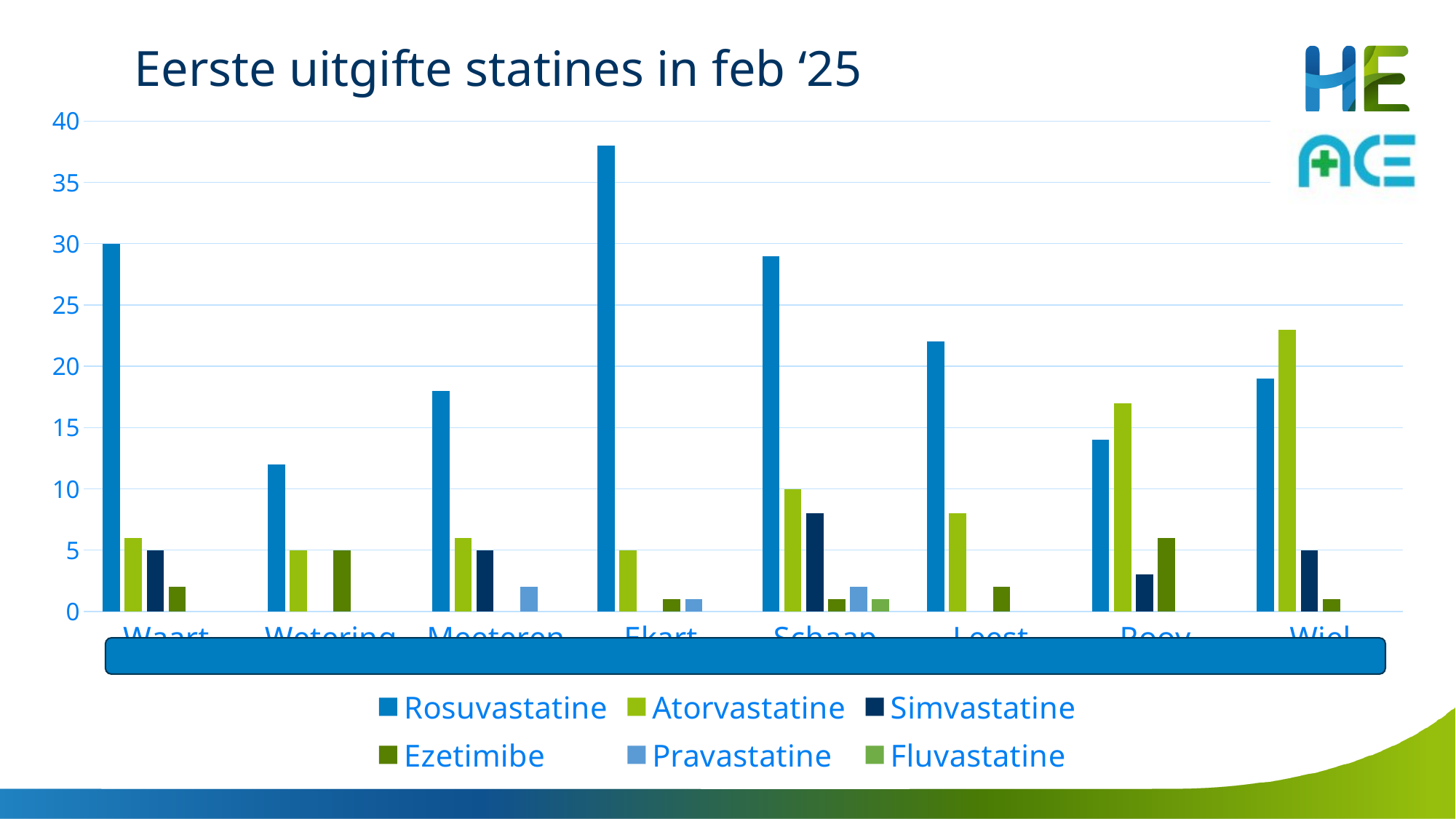
What is the title of the chart? Eerste uitgifte statines in feb ‘25 Is the Rosuvastatine value for Ekart greater or less than 35? greater How many series does the legend list? 6 For Wiel, which is larger: the Rosuvastatine bar or the Atorvastatine bar? Atorvastatine Which category has the lowest Rosuvastatine bar? Wetering Is the Rosuvastatine value for Schaap greater or less than 25? greater What is the Atorvastatine value for Schaap? 10 Which category has the highest Rosuvastatine bar? Ekart Is the Rosuvastatine value for Leest greater or less than 20? greater What is the Rosuvastatine value for Waart? 30 How many categories are shown along the x axis? 8 What kind of chart is shown on the slide? bar chart